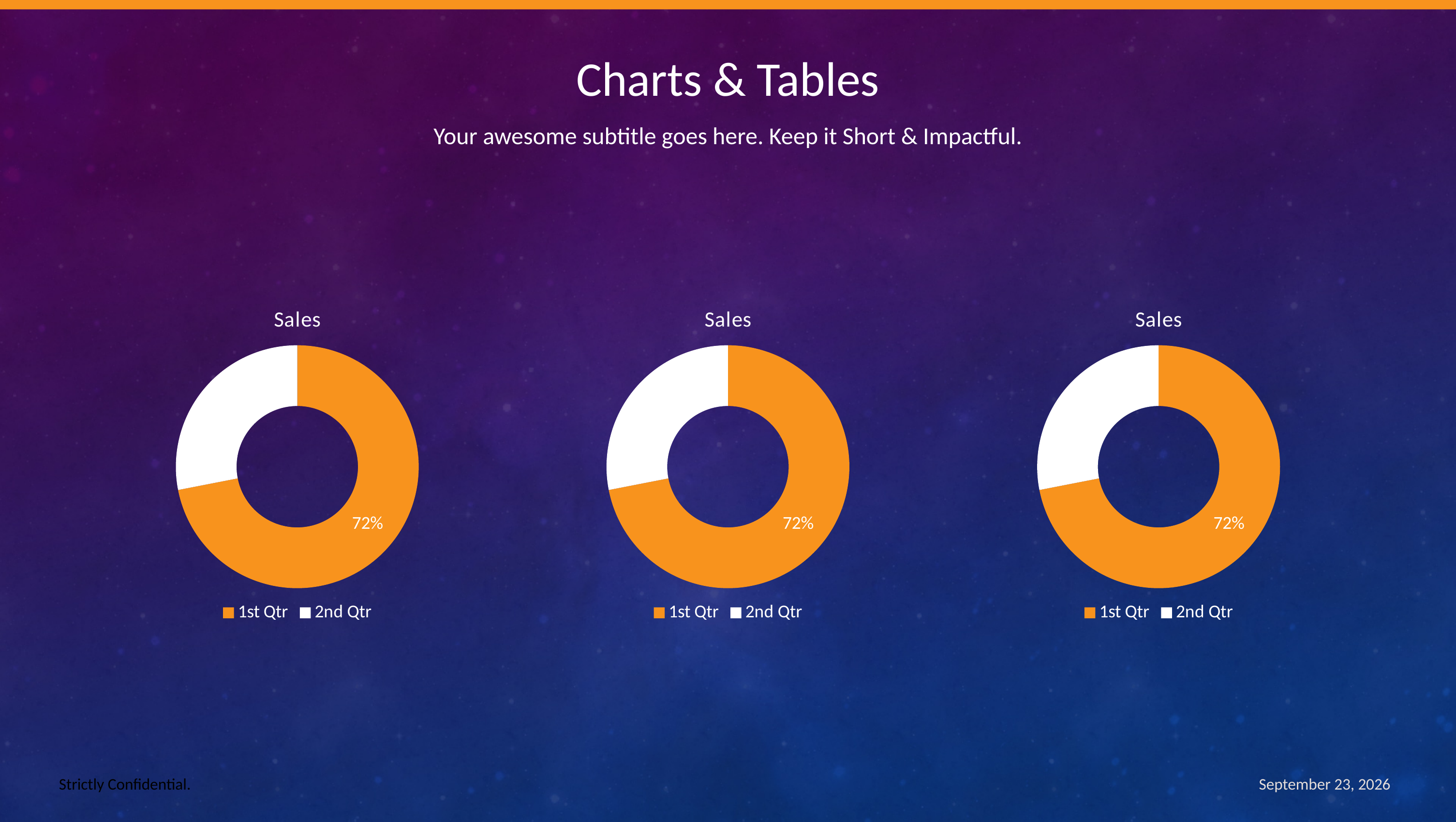
In the right chart, is the value for 1st Qtr greater or less than 50%? greater How many charts are shown on the slide? 3 In the right chart, which category has the smallest slice? 2nd Qtr In the left chart, what percentage is shown for 1st Qtr? 72% In the middle chart, what value is labelled on the 1st Qtr slice? 72% How many categories does the left chart's legend list? 2 What kind of chart is the middle chart? Doughnut chart In the left chart, which category has the largest slice? 1st Qtr In the middle chart, which is larger, 1st Qtr or 2nd Qtr? 1st Qtr In the left chart, what colour represents 1st Qtr? Orange What is the title of the right chart? Sales In the right chart, what share of the doughnut does 1st Qtr take? 72%